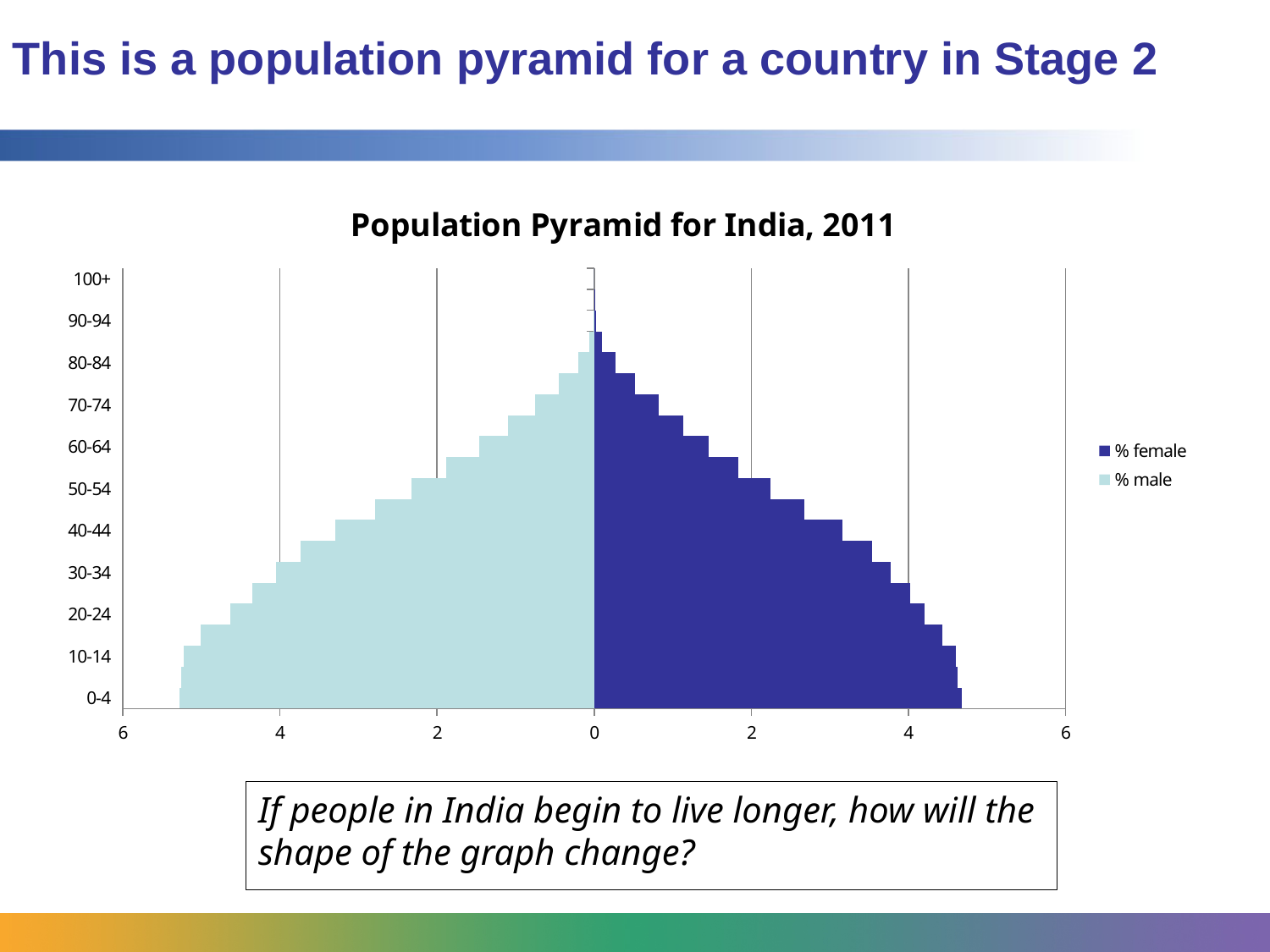
Which age group has the largest % female bar? 0-4 What type of chart is shown on the slide? bar chart (population pyramid) What is the title of the chart? Population Pyramid for India, 2011 Is the % male value for the 0-4 age group greater or less than 4? greater Which age group has the largest % male bar? 0-4 Which age group has the smallest bars for both % male and % female? 100+ Which series is shown in dark blue? % female How many series does the legend list? 2 Do the bars get longer or shorter as the age groups increase from 0-4 to 100+? shorter Is the % female value for the 60-64 age group greater or less than 2? less For the 0-4 age group, which is larger, % male or % female? % male Is the % female value for the 30-34 age group greater or less than 4? less